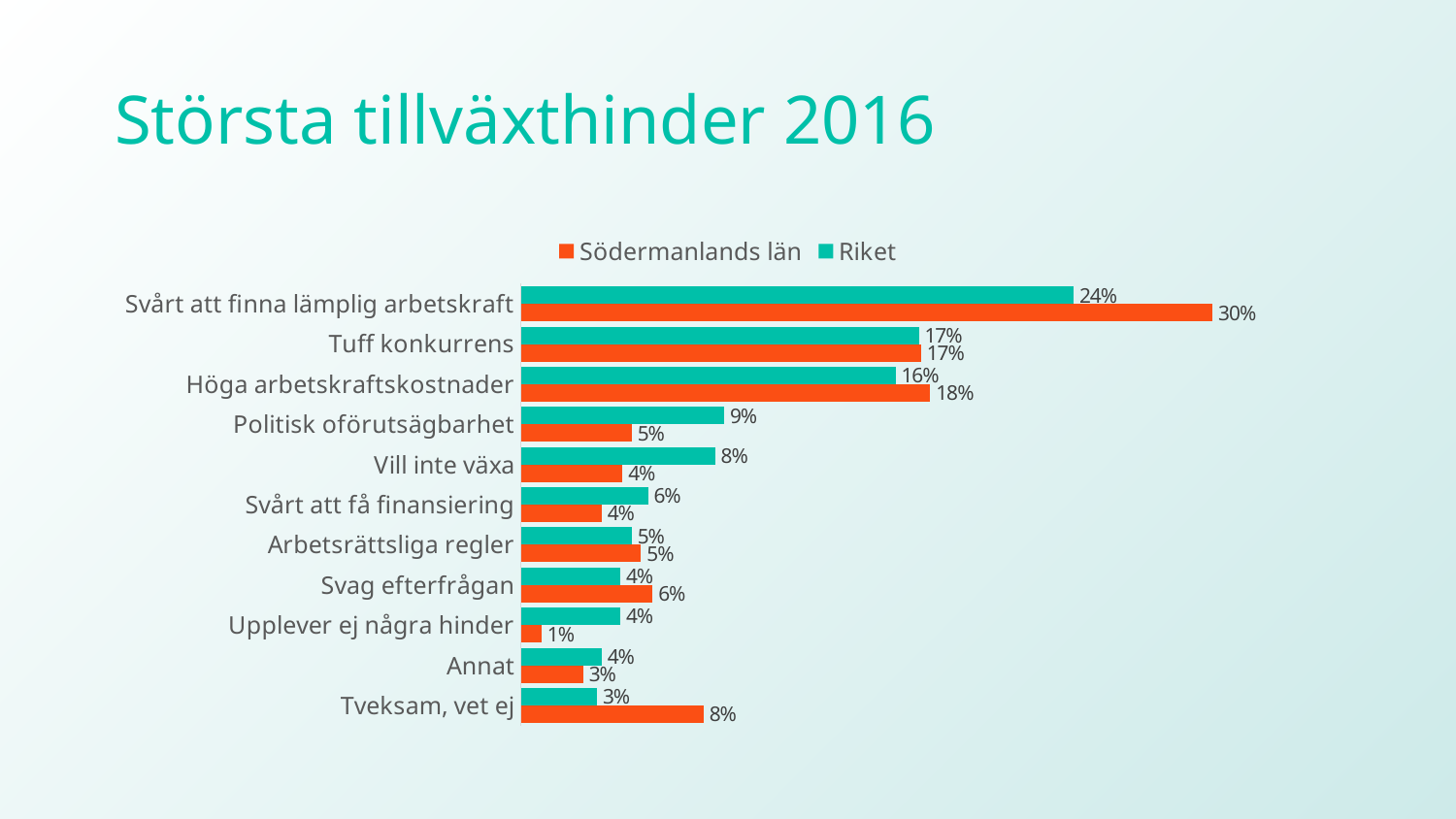
What is the difference between Södermanlands län and Riket for 'Svårt att finna lämplig arbetskraft'? 6% What kind of chart is shown on the slide? Bar chart What is the value for Södermanlands län for 'Tveksam, vet ej'? 8% What is the value for Riket for 'Politisk oförutsägbarhet'? 9% Which category has the lowest value for Södermanlands län? Upplever ej några hinder What is the title of the chart on the slide? Största tillväxthinder 2016 What is the value for Södermanlands län for 'Svårt att finna lämplig arbetskraft'? 30% Which category has the highest value for Riket? Svårt att finna lämplig arbetskraft For 'Vill inte växa', which is larger: Södermanlands län or Riket? Riket How many series does the legend list? 2 How many categories are shown in the chart? 11 What is the difference between Riket and Södermanlands län for 'Tveksam, vet ej'? 5%